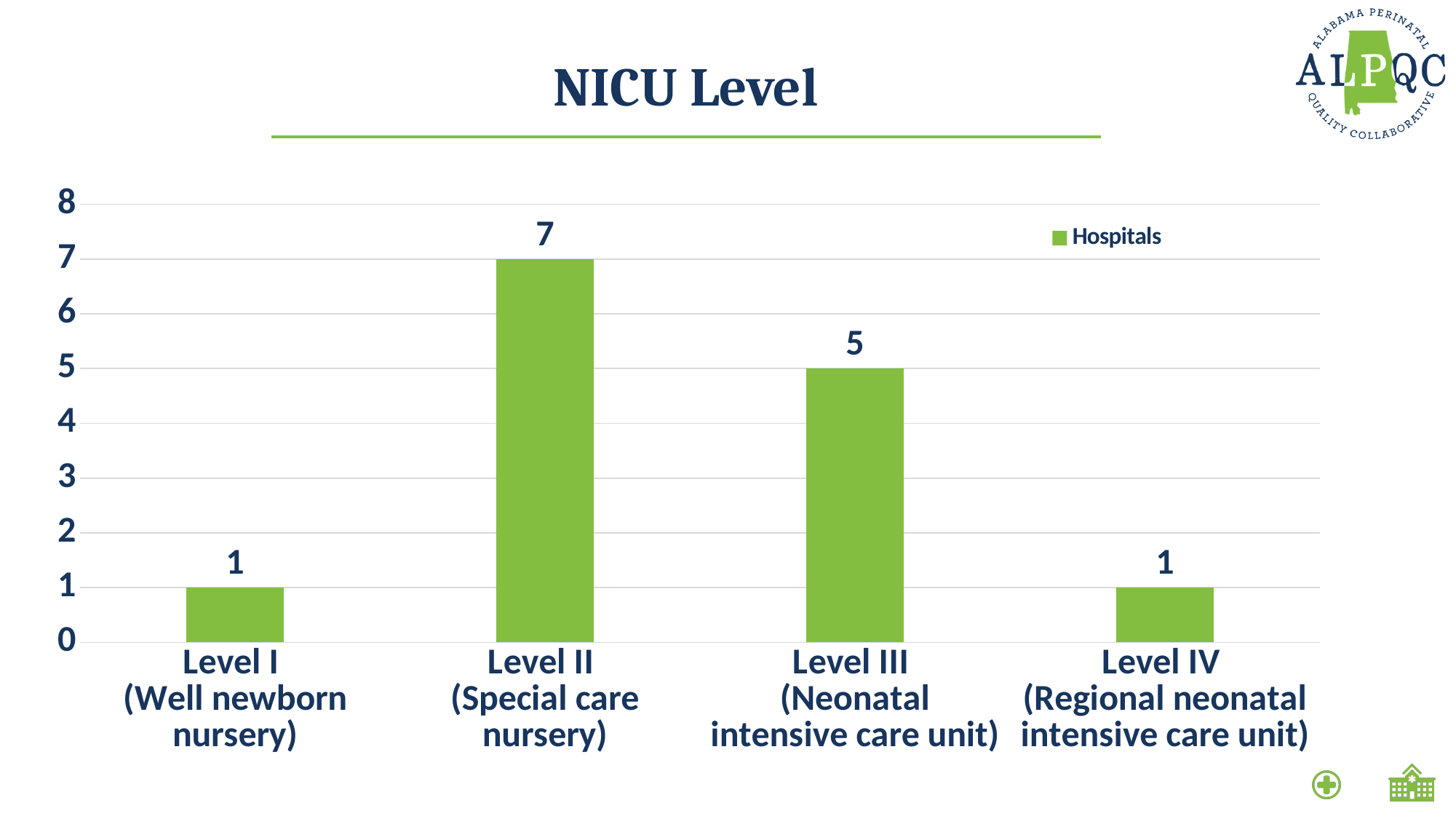
Which NICU level has the highest number of hospitals? Level II (Special care nursery) What is the title of the chart? NICU Level How many hospitals are shown for Level I (Well newborn nursery)? 1 What is the difference between the values for Level II and Level III? 2 How many hospitals are shown for Level II (Special care nursery)? 7 What kind of chart is shown on the slide? Bar chart What is the name of the series shown in the legend? Hospitals How many series does the legend list? 1 Which is larger, the value for Level III or the value for Level IV? Level III Is the value for Level II greater or less than 6? greater What is the value for Level III (Neonatal intensive care unit)? 5 How many NICU level categories are shown on the chart? 4